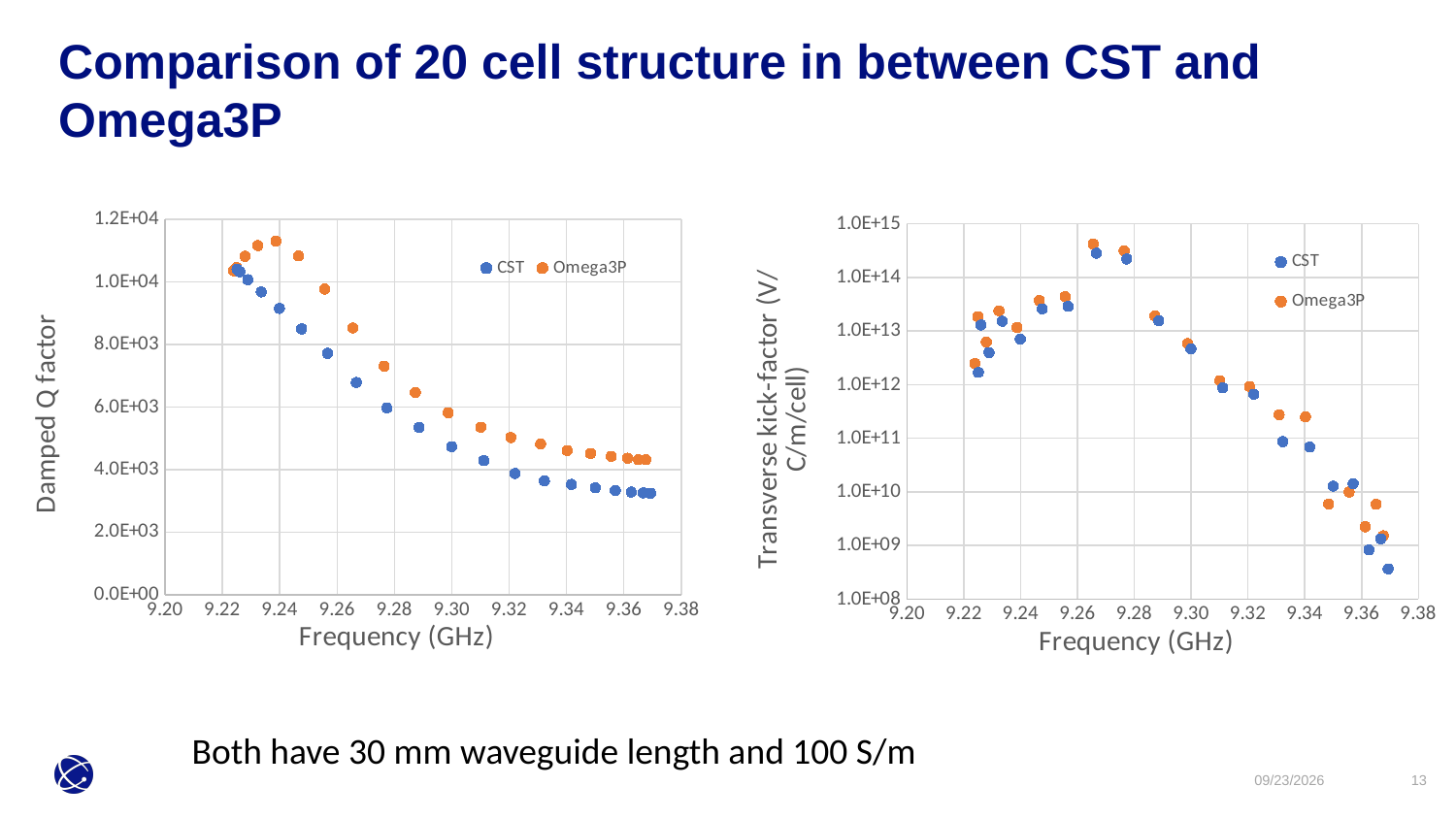
What are the two series named in the legend of the left chart? CST and Omega3P In the left chart, do the CST values rise or fall as frequency increases from 9.22 to 9.38 GHz? fall In the right chart, do the values rise or fall as frequency increases from 9.28 to 9.38 GHz? fall In the left chart, at about 9.24 GHz, which series has the larger Damped Q factor, CST or Omega3P? Omega3P What is the x-axis title of the right chart? Frequency (GHz) In the right chart, is the highest Omega3P kick-factor value greater or less than 1.0E+14? greater In the left chart, is the highest Omega3P value greater or less than 1.0E+04? greater How many series does the legend of the right chart (Transverse kick-factor) list? 2 In the right chart, at about 9.35 GHz, which series has the larger kick-factor, CST or Omega3P? CST In the right chart, is the lowest CST value (near 9.37 GHz) greater or less than 1.0E+09? less What kind of chart is the left chart (Damped Q factor vs Frequency)? scatter chart